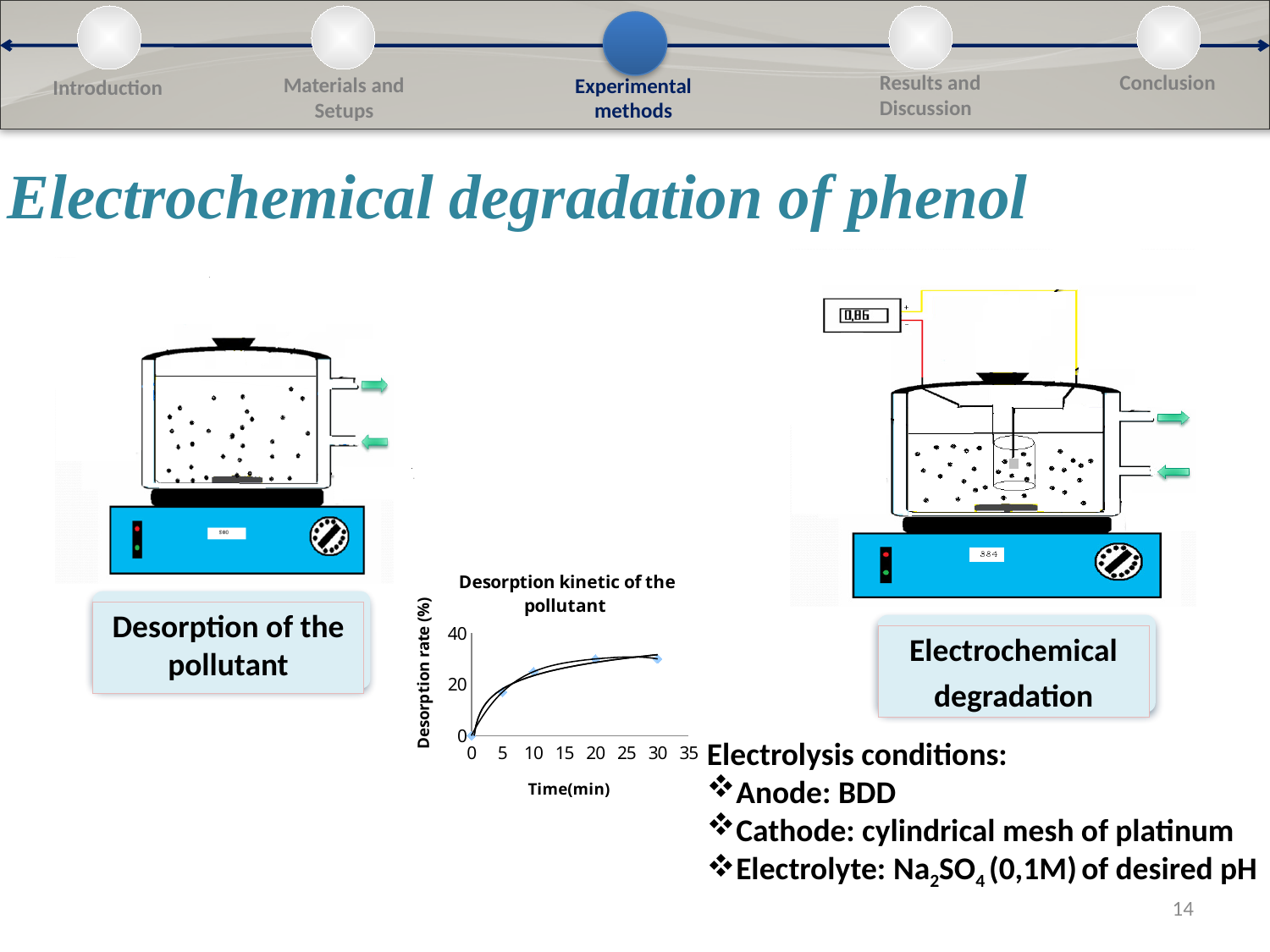
What kind of chart is the 'Desorption kinetic of the pollutant' chart? line chart What is the label of the x axis of the 'Desorption kinetic of the pollutant' chart? Time(min) In the 'Desorption kinetic of the pollutant' chart, does the desorption rate rise or fall as time increases? rise In the 'Desorption kinetic of the pollutant' chart, is the desorption rate at 30 min greater or less than 40? less In the 'Desorption kinetic of the pollutant' chart, what is the desorption rate at time 0? 0 In the 'Desorption kinetic of the pollutant' chart, is the desorption rate at 5 min greater or less than 20? less In the 'Desorption kinetic of the pollutant' chart, is the desorption rate at 20 min greater or less than 20? greater In the 'Desorption kinetic of the pollutant' chart, at which time is the desorption rate lowest? 0 In the 'Desorption kinetic of the pollutant' chart, which is larger: the desorption rate at 5 min or at 20 min? 20 min What is the highest value shown on the y axis of the 'Desorption kinetic of the pollutant' chart? 40 What is the title of the chart on the slide? Desorption kinetic of the pollutant